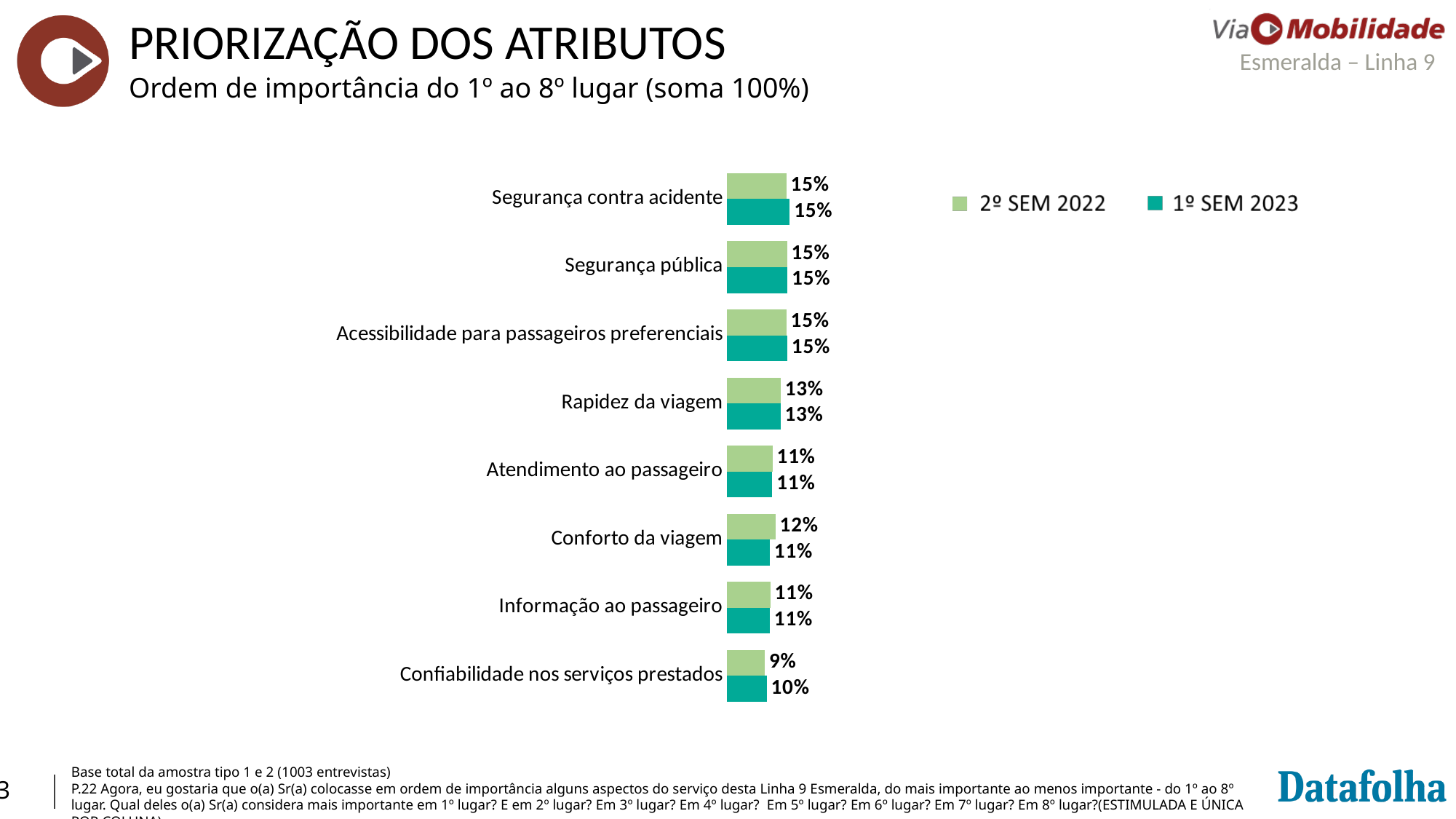
What is the value for Confiabilidade nos serviços prestados in the 1º SEM 2023 series? 10% Which category has the lowest value in the 1º SEM 2023 series? Confiabilidade nos serviços prestados What is the value for Rapidez da viagem in the 1º SEM 2023 series? 13% Which is larger for Confiabilidade nos serviços prestados: the 2º SEM 2022 value or the 1º SEM 2023 value? 1º SEM 2023 What is the value for Conforto da viagem in the 2º SEM 2022 series? 12% What is the difference between the 2º SEM 2022 and 1º SEM 2023 values for Conforto da viagem? 1% Which category has the lowest value in the 2º SEM 2022 series? Confiabilidade nos serviços prestados What is the value for Atendimento ao passageiro in the 2º SEM 2022 series? 11% How many series does the legend list? 2 What is the difference between the 1º SEM 2023 values for Segurança pública and Rapidez da viagem? 2% What kind of chart is shown on the slide? Bar chart How many categories are shown in the chart? 8